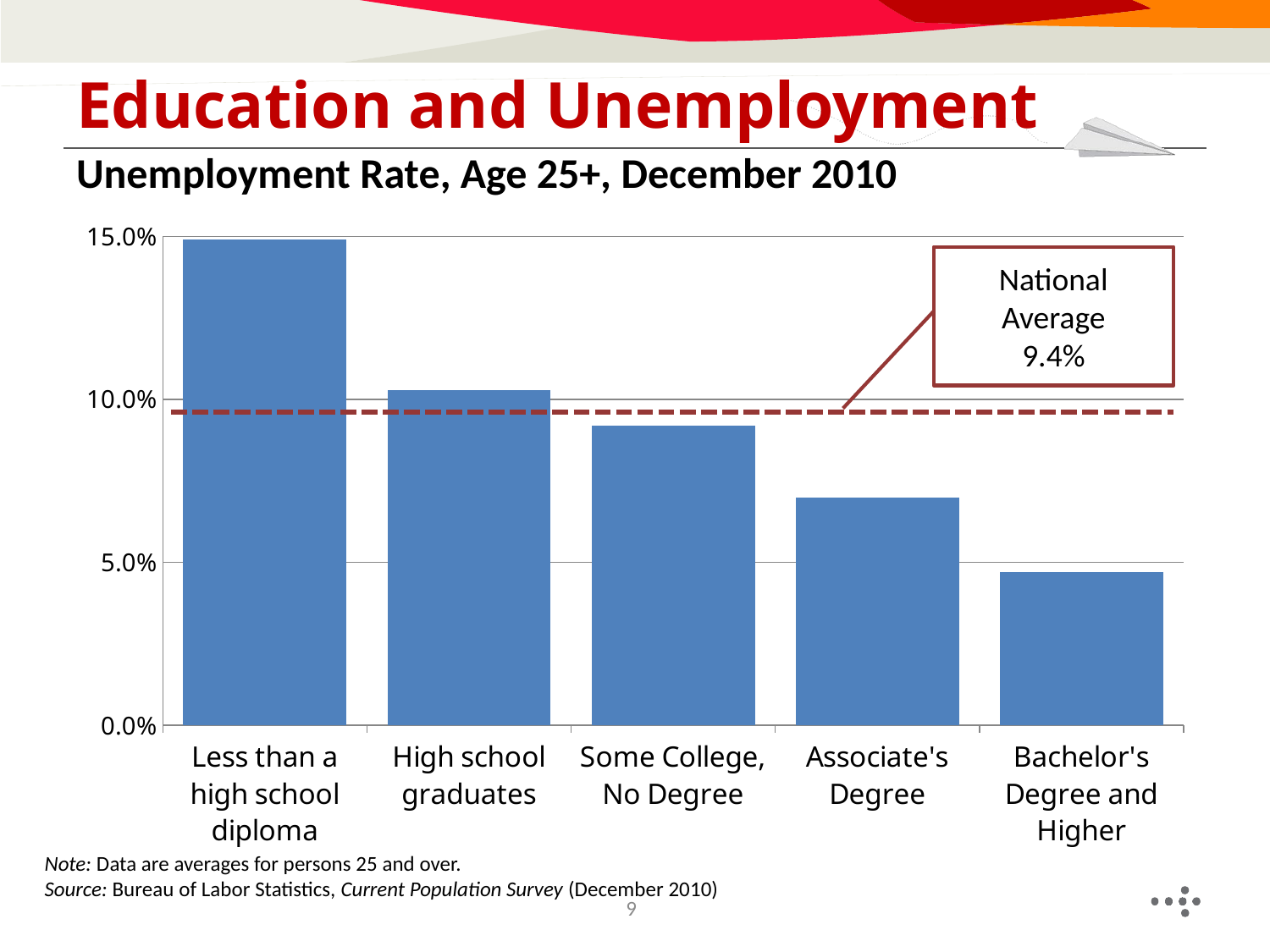
Is the unemployment rate for Less than a high school diploma greater or less than 10.0%? greater Do the unemployment rates rise or fall moving from left to right across the education categories? fall Which education category has the highest unemployment rate? Less than a high school diploma How many education categories are shown on the x axis? 5 What is the title of the chart? Unemployment Rate, Age 25+, December 2010 Which has a lower unemployment rate: Some College, No Degree or Bachelor's Degree and Higher? Bachelor's Degree and Higher Is the unemployment rate for Some College, No Degree greater or less than 10.0%? less Is the unemployment rate for Associate's Degree greater or less than 5.0%? greater Which has a higher unemployment rate: High school graduates or Associate's Degree? High school graduates Which education category has the lowest unemployment rate? Bachelor's Degree and Higher What kind of chart is shown on the slide? bar chart What is the national average unemployment rate shown by the dashed line? 9.4%